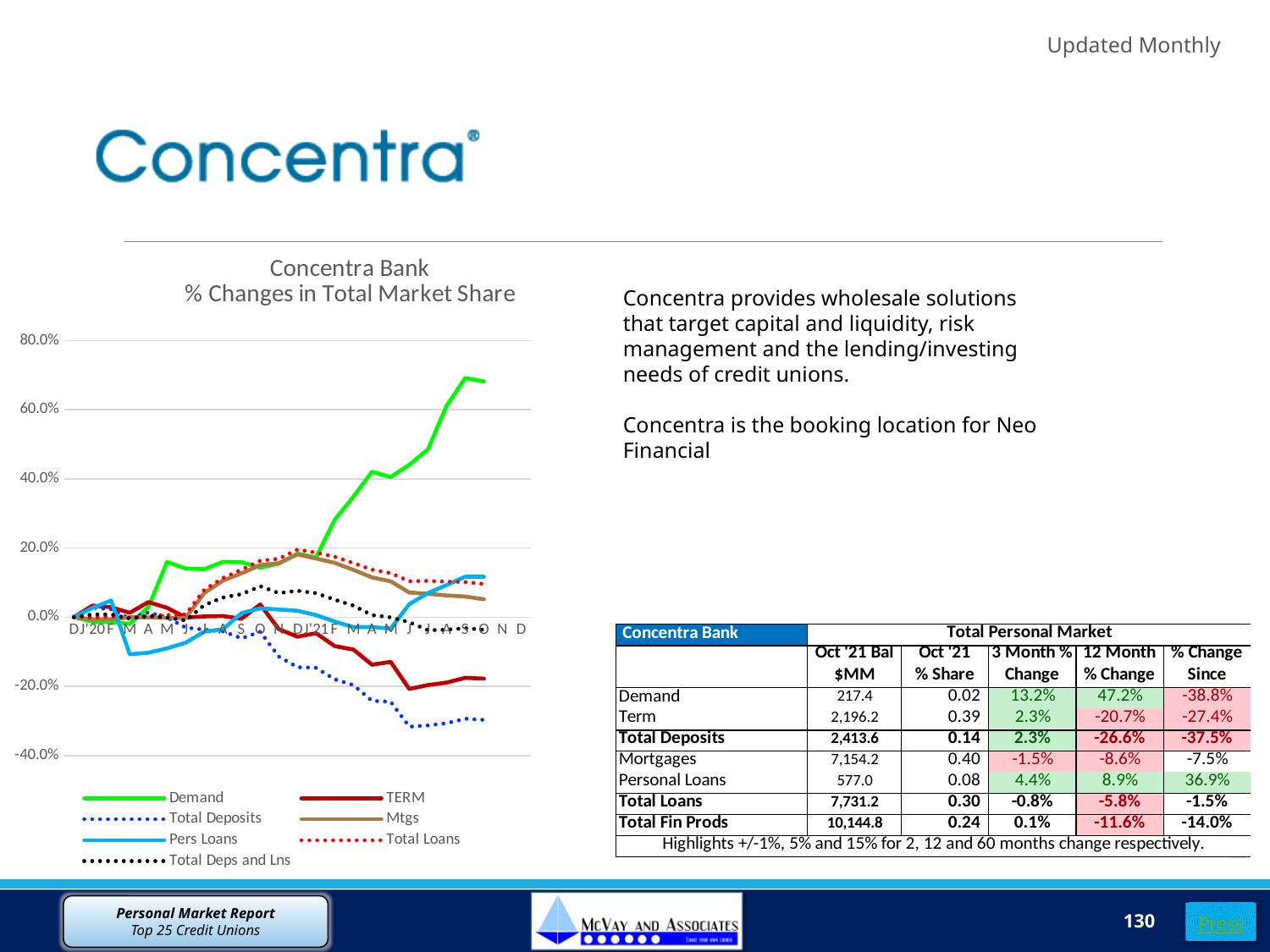
What is the title of the chart? Concentra Bank % Changes in Total Market Share Is the final value for Mtgs greater or less than 0.0%? greater How many series does the chart legend list? 7 What kind of chart is shown on the slide? line chart Which series reaches the highest value at the right end of the chart? Demand Is the final value for Total Deposits greater or less than -20.0%? less Is the final value for TERM greater or less than 0.0%? less Does the Total Deposits series generally rise or fall across 2021? fall Which series has the lowest value at the right end of the chart? Total Deposits Does the Demand series generally rise or fall across 2021? rise At the right end of the chart, which is larger: Demand or TERM? Demand